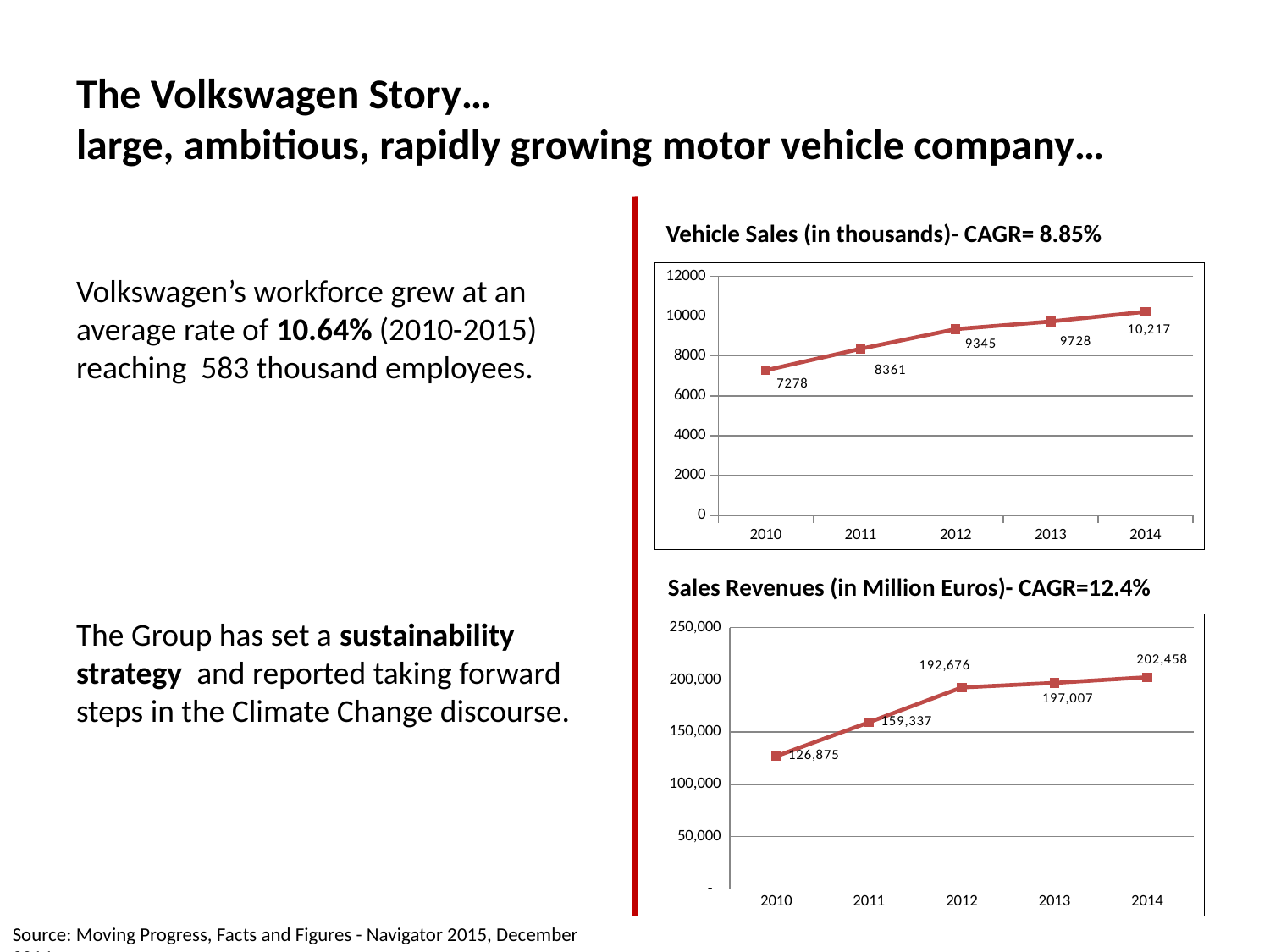
In the Vehicle Sales chart, which year has the lowest value? 2010 In the Vehicle Sales chart, what is the value for 2010? 7278 In the Vehicle Sales chart, how many years are plotted? 5 In the Sales Revenues chart, what is the value for 2011? 159,337 In the Sales Revenues chart, what is the difference between the 2014 and 2010 values? 75,583 In the Sales Revenues chart, is the value for 2012 larger than the value for 2011? Yes In the Sales Revenues chart, which year has the highest value? 2014 In the Vehicle Sales chart, do the values rise or fall from 2010 to 2014? rise What kind of chart is the Sales Revenues chart? line chart In the Vehicle Sales chart, what is the difference between the 2012 and 2011 values? 984 In the Vehicle Sales chart, what is the value for 2014? 10,217 In the Sales Revenues chart, what is the value for 2013? 197,007